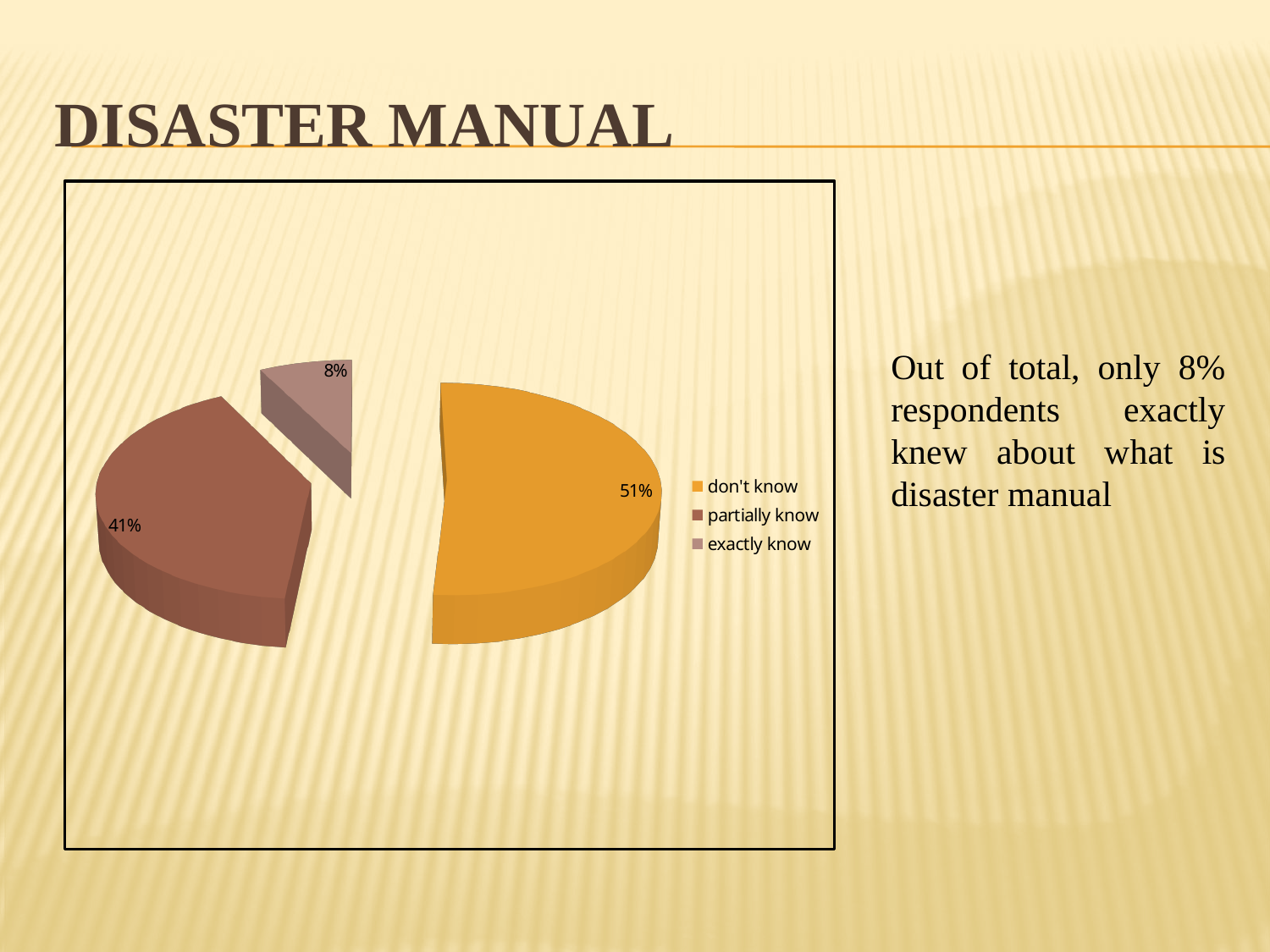
Which category has the smallest share of the pie? exactly know Which is larger, the share for 'partially know' or the share for 'exactly know'? partially know Which category has the largest share of the pie? don't know What kind of chart is shown on the slide? pie chart What is the difference in percentage points between 'don't know' and 'partially know'? 10 How many categories does the pie chart show? 3 What percentage of respondents don't know about the disaster manual? 51% What is the difference in percentage points between 'partially know' and 'exactly know'? 33 What percentage of respondents partially know about the disaster manual? 41% What colour is the 'don't know' slice? orange What percentage of respondents exactly know about the disaster manual? 8%